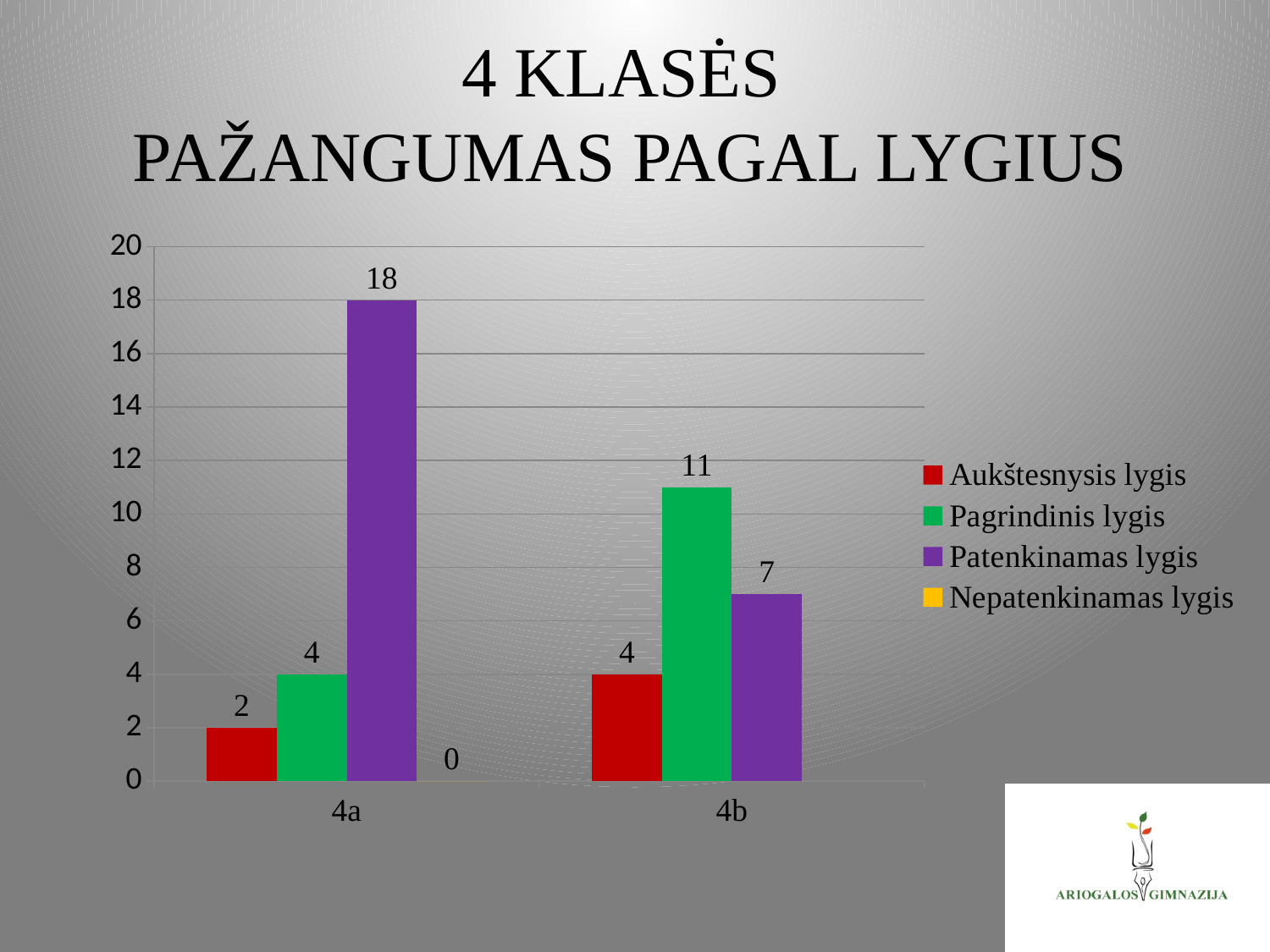
What is the difference between Patenkinamas lygis in class 4a and Patenkinamas lygis in class 4b? 11 What is the value for Patenkinamas lygis in class 4a? 18 Which level has the highest value in class 4b? Pagrindinis lygis What is the value for Aukštesnysis lygis in class 4a? 2 What is the value for Pagrindinis lygis in class 4b? 11 What is the value for Nepatenkinamas lygis in class 4a? 0 What kind of chart is shown on the slide? Bar chart How many classes (categories) are shown on the x axis? 2 Which level has the highest value in class 4a? Patenkinamas lygis What colour represents Pagrindinis lygis in the legend? Green Which is larger: Aukštesnysis lygis in class 4a or Aukštesnysis lygis in class 4b? 4b How many series does the legend list? 4